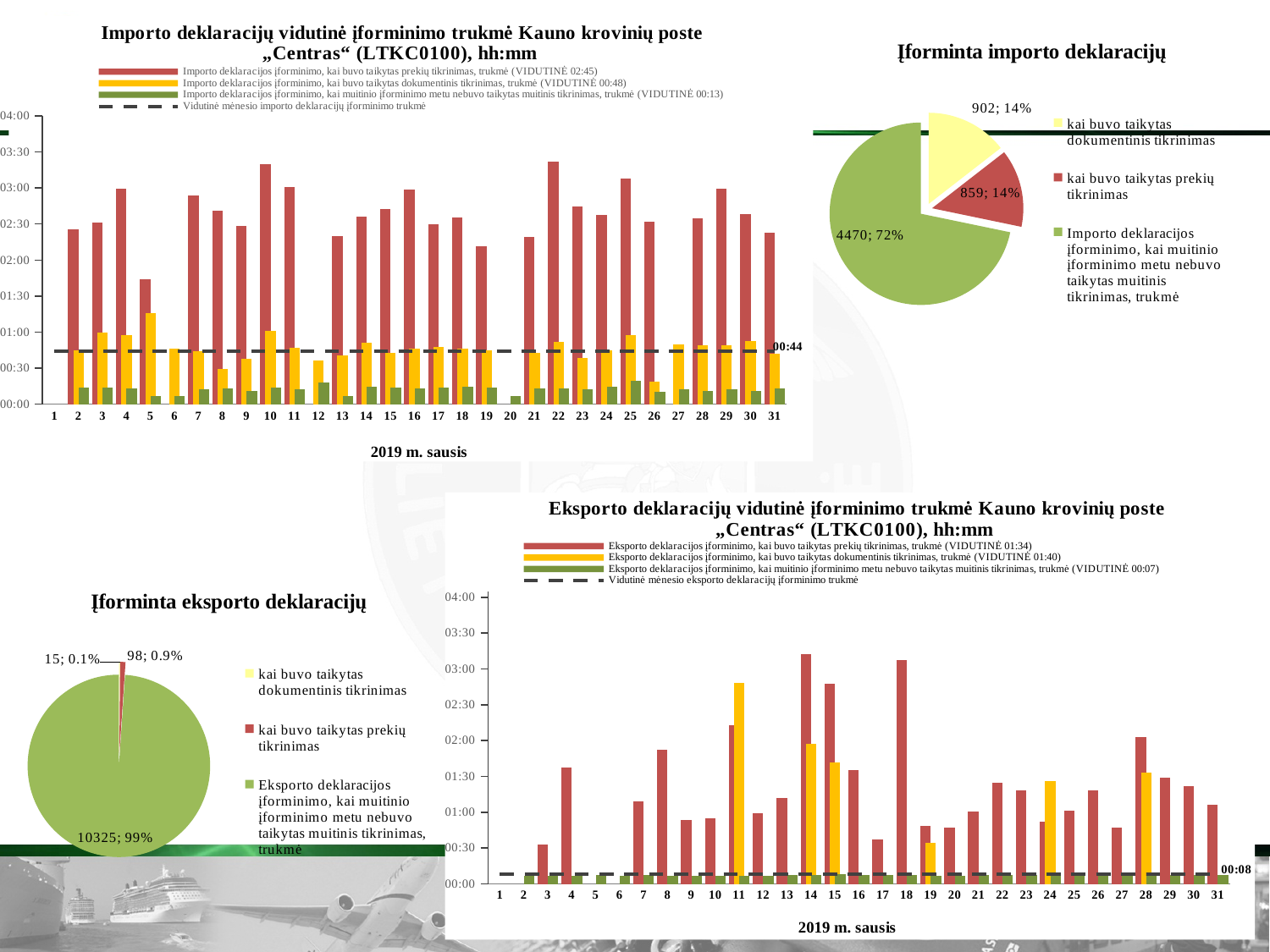
In the pie chart "Įforminta importo deklaracijų", what value is shown for the slice "kai buvo taikytas dokumentinis tikrinimas"? 902; 14% In the top-left bar chart about import declarations, how many entries does the legend list? 4 In the pie chart "Įforminta eksporto deklaracijų", which is larger: the slice for "kai buvo taikytas dokumentinis tikrinimas" or the slice for "kai buvo taikytas prekių tikrinimas"? kai buvo taikytas prekių tikrinimas In the top-left bar chart about import declarations, what value is labelled on the dashed average line? 00:44 In the pie chart "Įforminta eksporto deklaracijų", what value is shown for the slice "kai buvo taikytas prekių tikrinimas"? 98; 0.9% In the pie chart "Įforminta eksporto deklaracijų", which slice is the largest? Eksporto deklaracijos įforminimo, kai muitinio įforminimo metu nebuvo taikytas muitinis tikrinimas, trukmė (10325; 99%) In the top-left bar chart about import declarations, is the red bar for day 10 greater or less than 03:00? greater In the pie chart "Įforminta importo deklaracijų", what share of the pie is the slice for declarations where no customs check was applied (the green slice)? 72% In the bottom-right bar chart about export declarations, what value is labelled on the dashed average line? 00:08 In the pie chart "Įforminta importo deklaracijų", what is the difference between the count for "kai buvo taikytas dokumentinis tikrinimas" and the count for "kai buvo taikytas prekių tikrinimas"? 43 In the top-left bar chart about import declarations, how many days (categories) are shown on the x axis? 31 What kind of chart is the top-left chart "Importo deklaracijų vidutinė įforminimo trukmė Kauno krovinių poste „Centras“ (LTKC0100), hh:mm"? bar chart